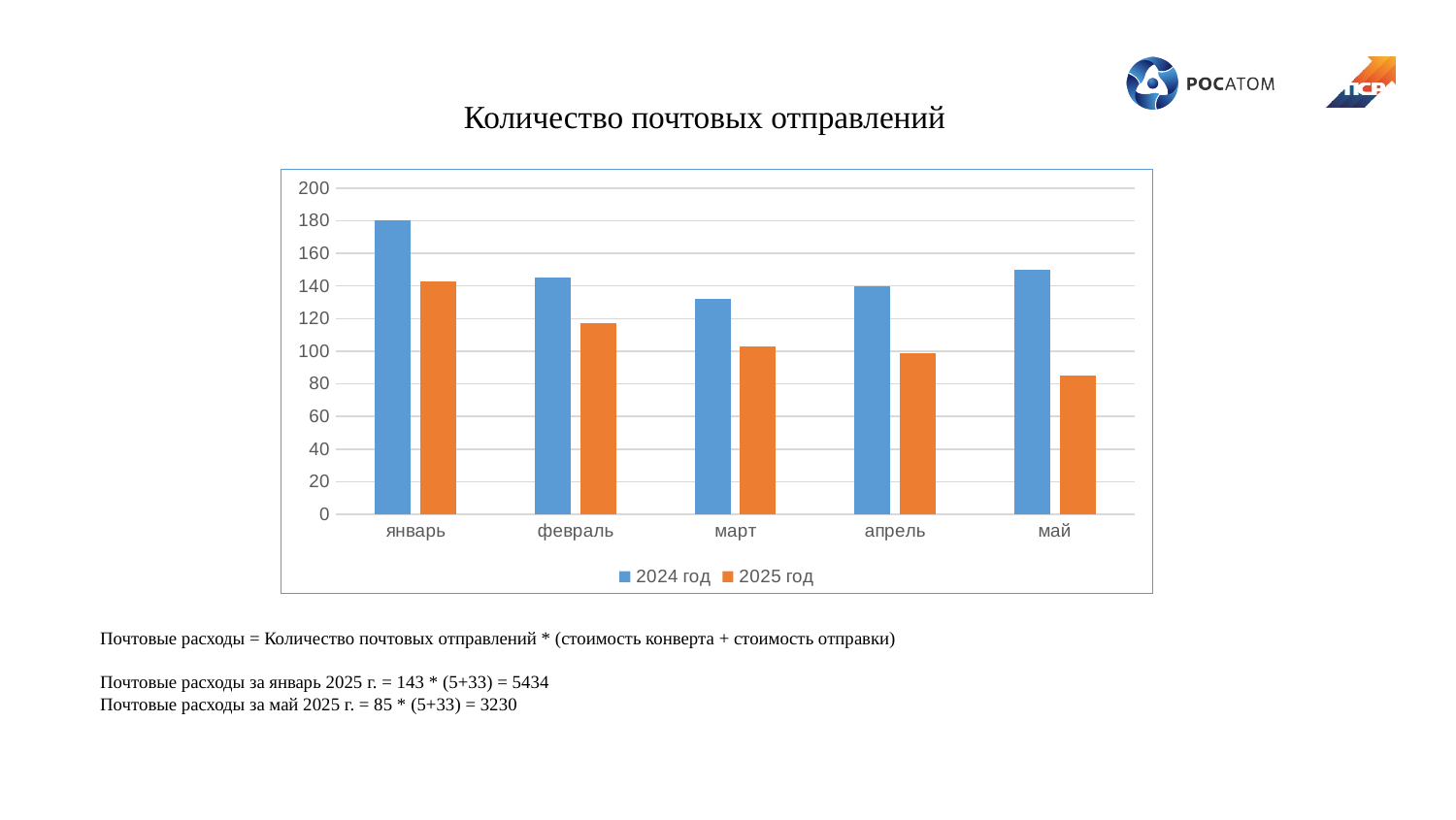
Do the values for 2025 год rise or fall from январь to май? fall How many months are shown on the x axis? 5 Which month has the highest value for 2024 год? январь Is the value for 2024 год in май greater or less than 140? greater What kind of chart is shown on the slide? bar chart How many series does the legend list? 2 In январь, which series has the larger value, 2024 год or 2025 год? 2024 год Which month has the lowest value for 2025 год? май What is the title of the chart? Количество почтовых отправлений Is the value for 2024 год in март greater or less than 120? greater According to the text below the chart, what is the number of postal items for январь 2025? 143